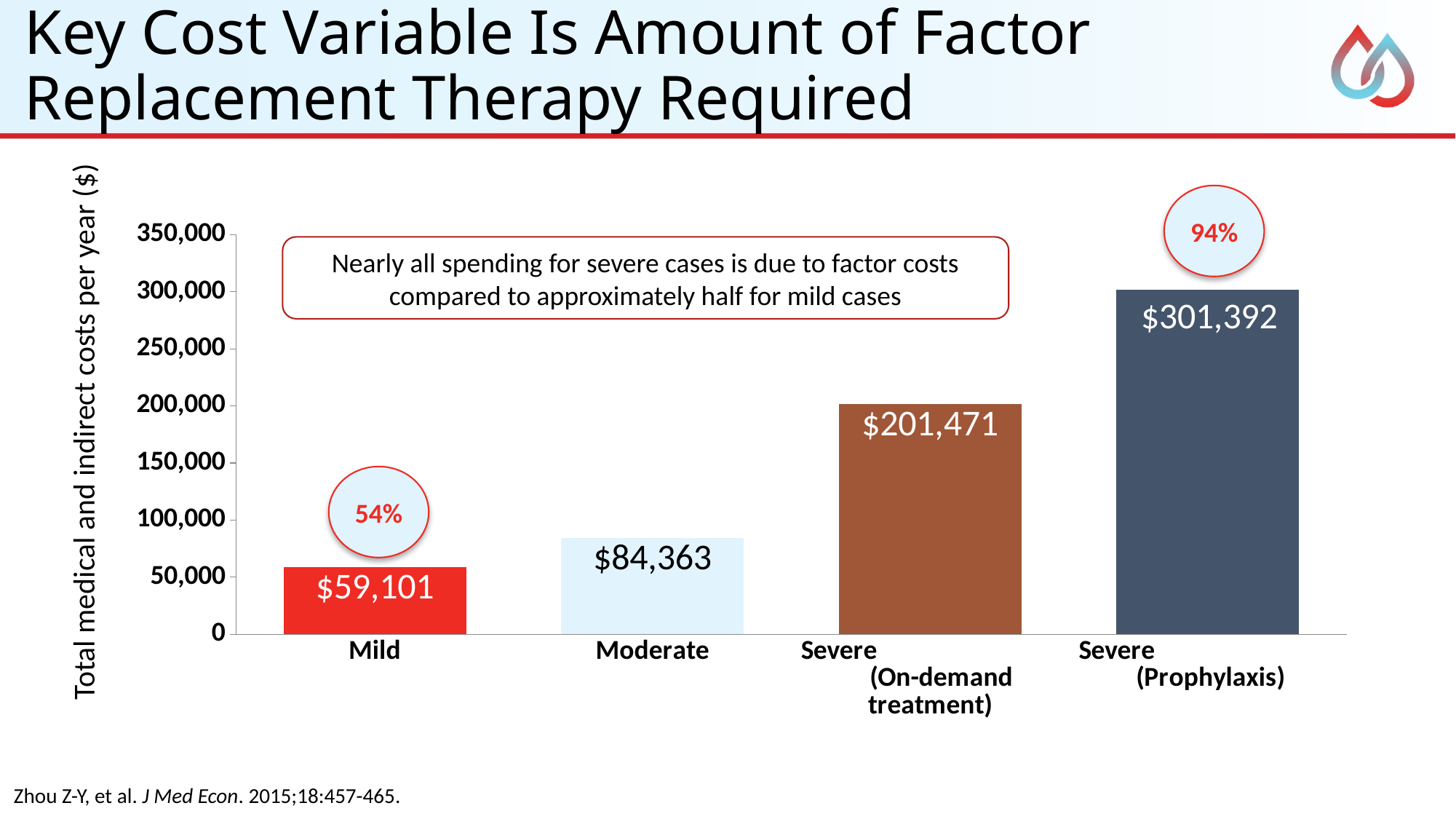
What is the difference in cost per year between Moderate and Mild cases? $25,262 How many categories are shown on the x axis of the chart? 4 What is the difference in cost per year between Severe (Prophylaxis) and Severe (On-demand treatment)? $99,921 Which has a higher cost per year, Moderate or Severe (On-demand treatment)? Severe (On-demand treatment) What kind of chart is shown on the slide? Bar chart Which category has the highest total medical and indirect cost per year? Severe (Prophylaxis) What is the total medical and indirect cost per year for Moderate cases? $84,363 What is the total medical and indirect cost per year for Severe (Prophylaxis) cases? $301,392 Which category has the lowest total medical and indirect cost per year? Mild What percentage is shown in the circle above the Severe (Prophylaxis) bar? 94% What is the total medical and indirect cost per year for Mild cases? $59,101 What is the total medical and indirect cost per year for Severe (On-demand treatment) cases? $201,471